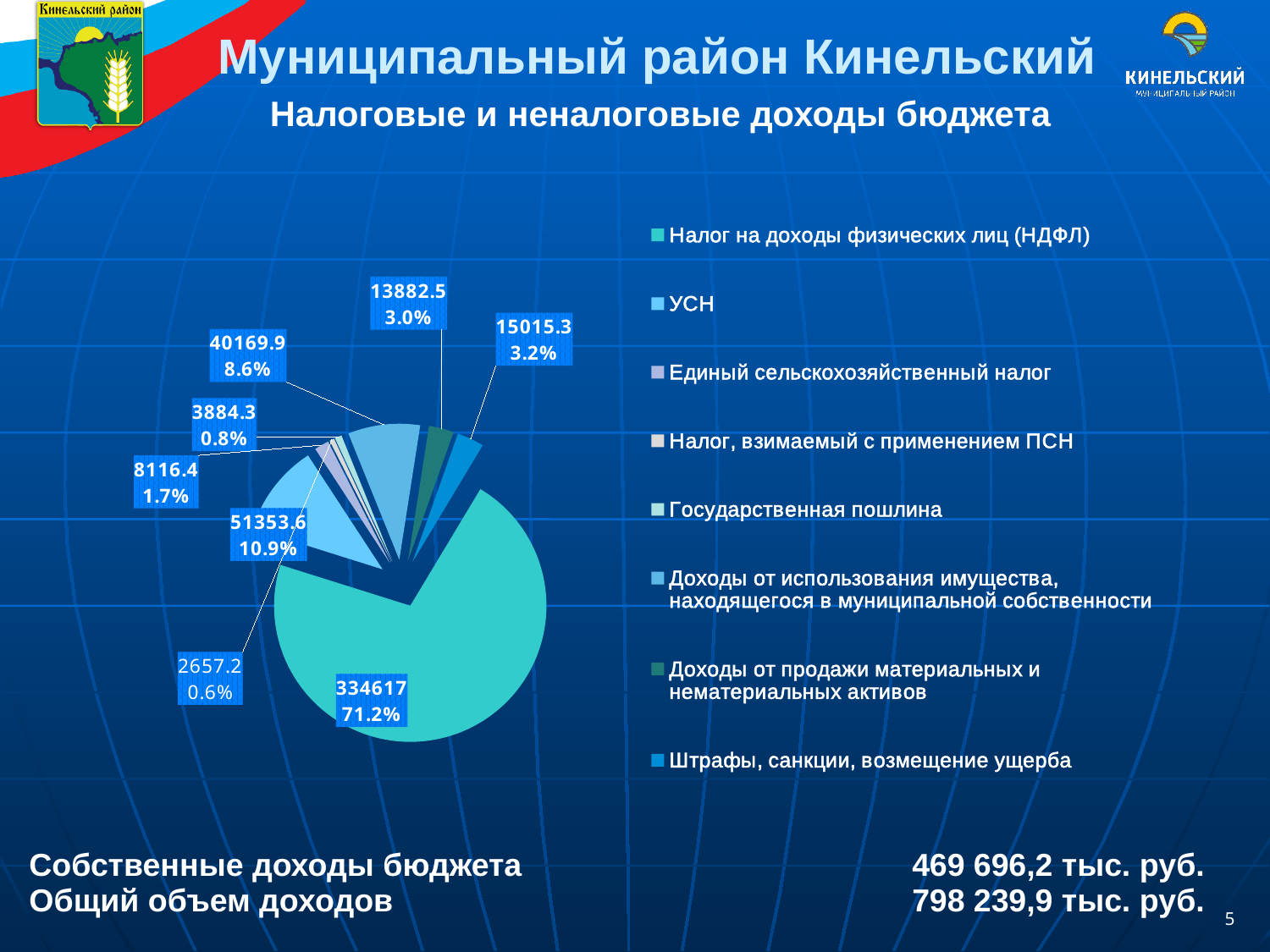
What share of the pie does Налог на доходы физических лиц (НДФЛ) take? 71.2% What value is shown for УСН? 51353.6 How many categories does the legend of the pie chart list? 8 What is the difference between the value for УСН and the value for Доходы от использования имущества, находящегося в муниципальной собственности? 11183.7 What value is shown for Доходы от использования имущества, находящегося в муниципальной собственности? 40169.9 What share of the pie does УСН take? 10.9% Which is larger: Штрафы, санкции, возмещение ущерба or Доходы от продажи материальных и нематериальных активов? Штрафы, санкции, возмещение ущерба What value is shown for Налог на доходы физических лиц (НДФЛ)? 334617 What value is shown for Штрафы, санкции, возмещение ущерба? 15015.3 Which category has the largest slice of the pie? Налог на доходы физических лиц (НДФЛ) What kind of chart is shown on the slide? pie chart What share of the pie does Доходы от продажи материальных и нематериальных активов take? 3.0%